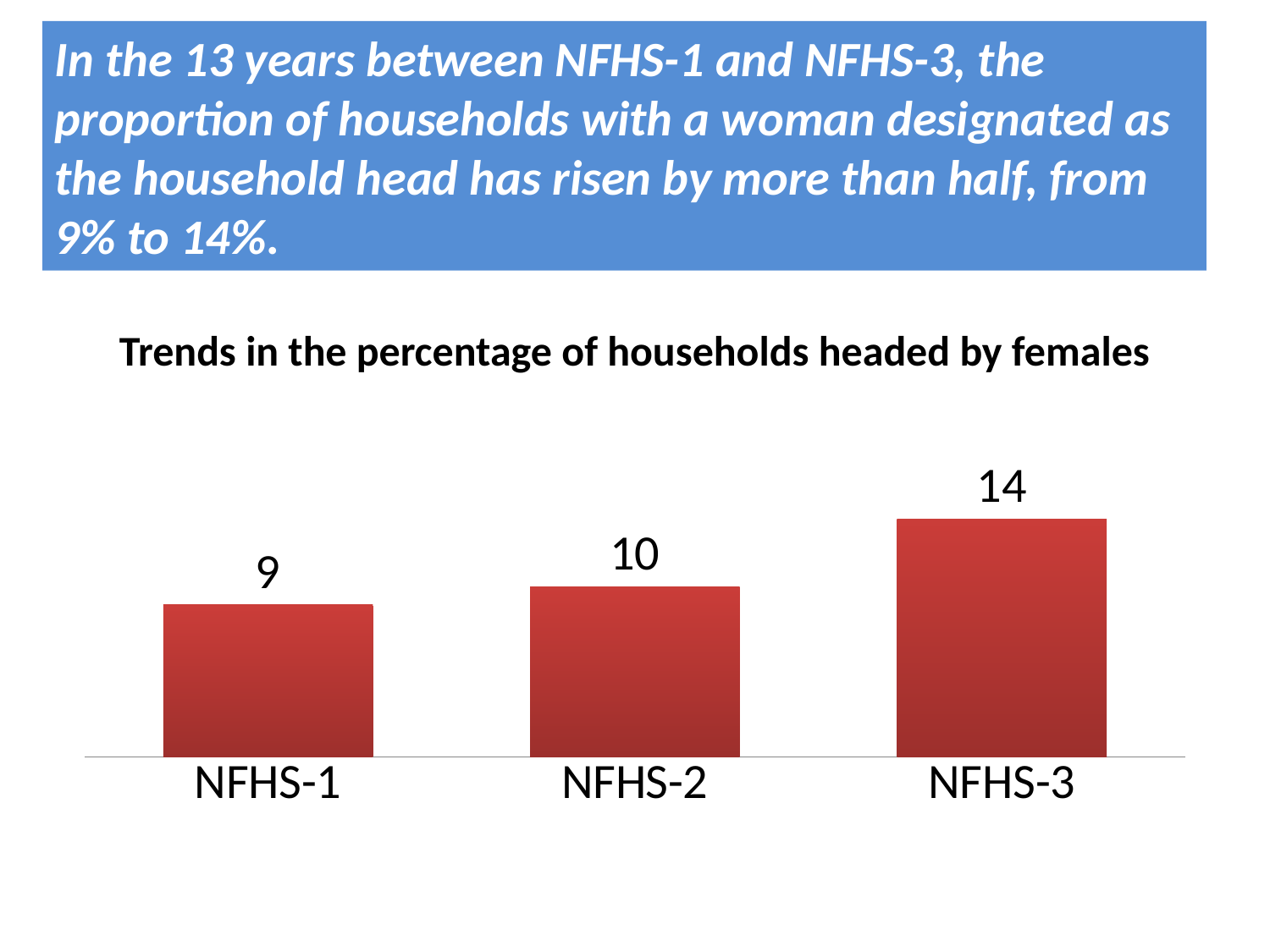
What is the value for NFHS-1? 9 Do the values rise or fall from NFHS-1 to NFHS-3? Rise Which is larger, the value for NFHS-2 or the value for NFHS-3? NFHS-3 What kind of chart is shown on the slide? Bar chart What is the difference between the values for NFHS-3 and NFHS-1? 5 What is the value for NFHS-2? 10 What is the title of the chart? Trends in the percentage of households headed by females What is the difference between the values for NFHS-3 and NFHS-2? 4 Which survey has the highest percentage of households headed by females? NFHS-3 What is the value for NFHS-3? 14 Which survey has the lowest percentage of households headed by females? NFHS-1 How many categories are shown in the chart? 3